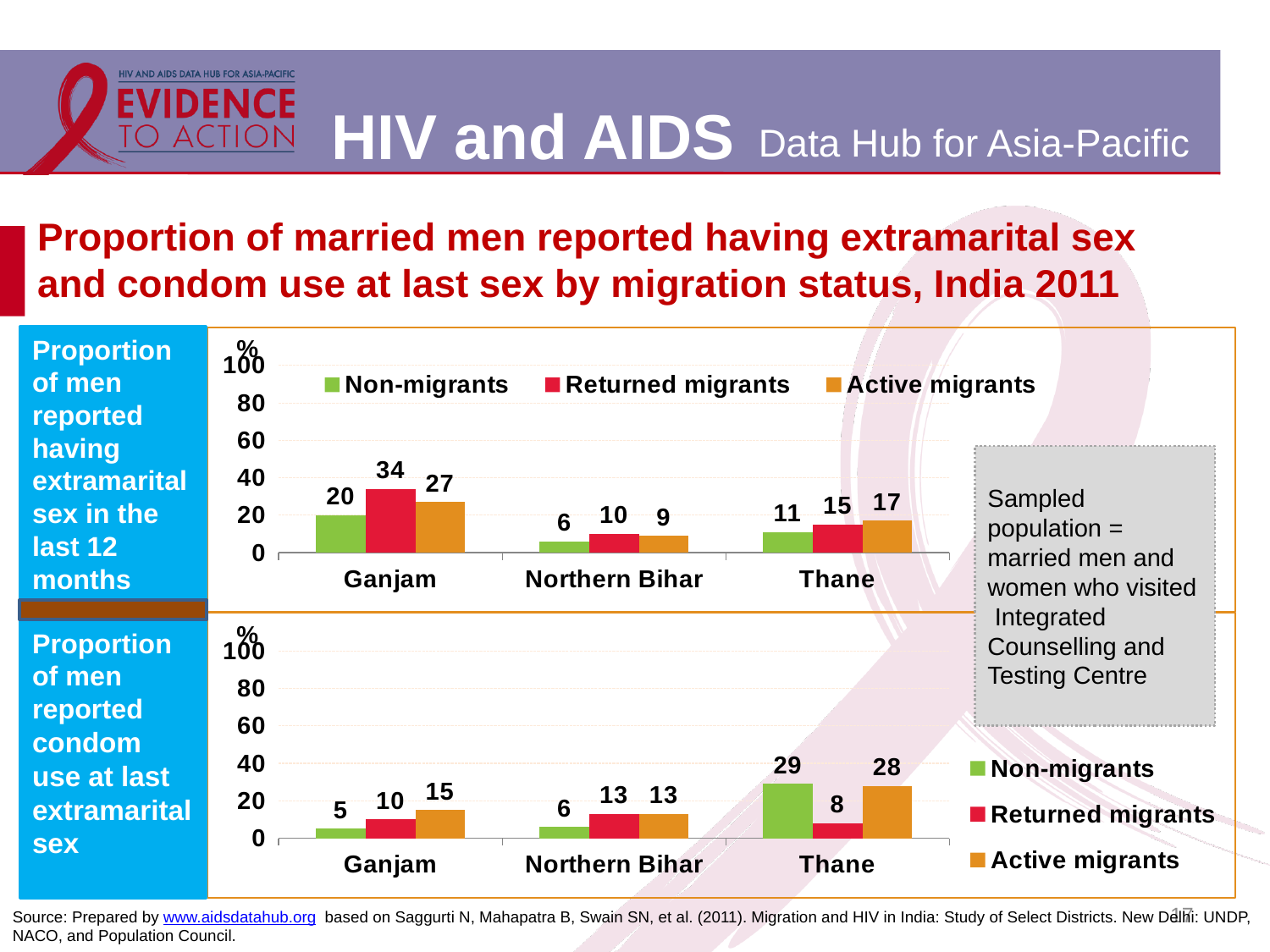
In the top chart (extramarital sex in the last 12 months), what is the value for Active migrants in Thane? 17 In the top chart (extramarital sex in the last 12 months), what is the value for Returned migrants in Ganjam? 34 In the bottom chart (condom use at last extramarital sex), what is the value for Non-migrants in Thane? 29 How many series does the legend of the top chart list? 3 How many districts are shown on the x axis of the top chart? 3 In the bottom chart (condom use at last extramarital sex), which is larger in Thane: Non-migrants or Returned migrants? Non-migrants In the bottom chart (condom use at last extramarital sex), which district has the lowest value for Non-migrants? Ganjam In the bottom chart (condom use at last extramarital sex), is the value for Non-migrants in Thane greater or less than 20? greater What kind of chart is the bottom chart (condom use at last extramarital sex)? Bar chart In the top chart (extramarital sex in the last 12 months), which district has the highest value for Non-migrants? Ganjam In the top chart (extramarital sex in the last 12 months), what is the difference between Returned migrants and Non-migrants in Ganjam? 14 In the bottom chart (condom use at last extramarital sex), what is the value for Returned migrants in Northern Bihar? 13